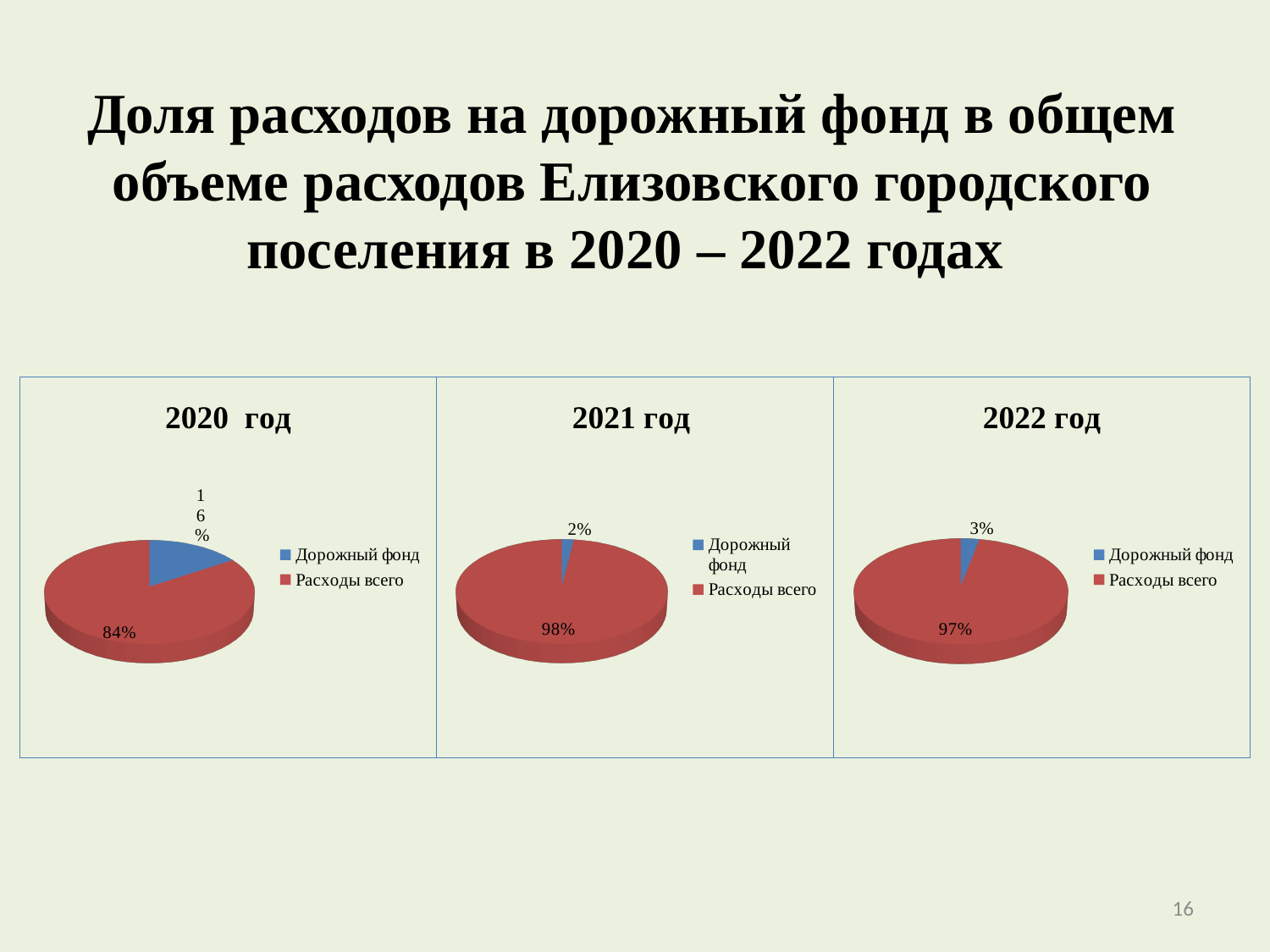
What kind of chart is the "2021 год" chart? Pie chart How many slices does the "2022 год" pie chart have? 2 In the "2021 год" chart, what share is labelled for Расходы всего? 98% What is the difference between the Дорожный фонд share in the "2020 год" chart and in the "2022 год" chart? 13% In the "2020 год" chart, what share is labelled for Расходы всего? 84% In the "2020 год" chart, what share is labelled for Дорожный фонд? 16% In the "2021 год" chart, what share is labelled for Дорожный фонд? 2% In the "2022 год" chart, what share is labelled for Дорожный фонд? 3% Which of the three pie charts shows the largest share for Дорожный фонд? 2020 год In the "2020 год" chart, which slice is larger, Дорожный фонд or Расходы всего? Расходы всего How many entries does the legend of the "2020 год" chart list? 2 In the "2022 год" chart, what share is labelled for Расходы всего? 97%